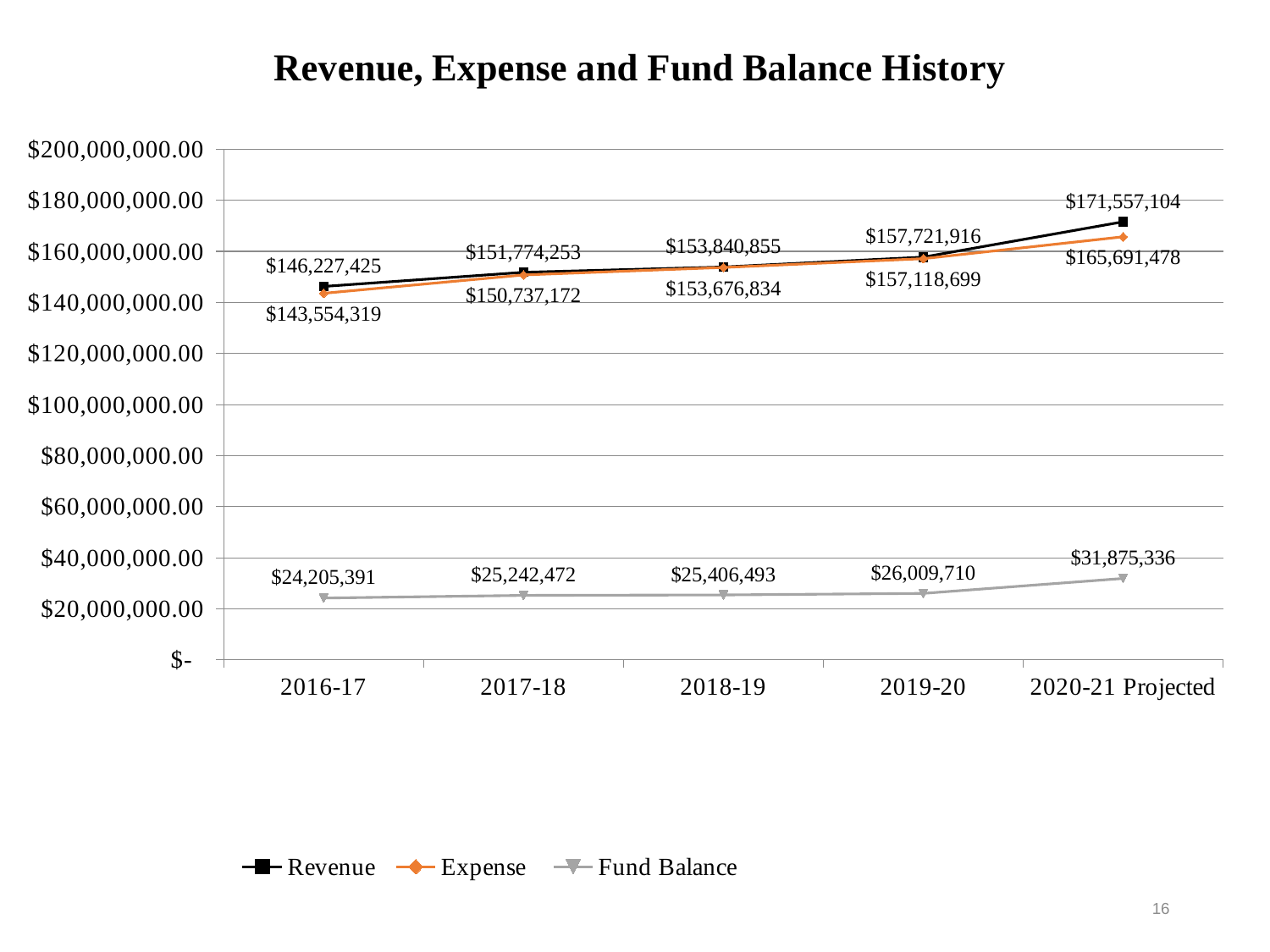
In which year is the Fund Balance lowest? 2016-17 How many fiscal years are plotted along the x axis? 5 How many series does the legend list? 3 What is the Revenue value for 2018-19? $153,840,855 Which is larger in 2016-17, Revenue or Expense? Revenue What type of chart is shown on the slide? Line chart What is the title of the chart? Revenue, Expense and Fund Balance History In which year is Revenue highest? 2020-21 Projected What is the Expense value for 2017-18? $150,737,172 What is the Fund Balance value for 2019-20? $26,009,710 What is the difference between Revenue and Expense in 2020-21 Projected? $5,865,626 Does the Fund Balance rise or fall from 2016-17 to 2020-21 Projected? Rise